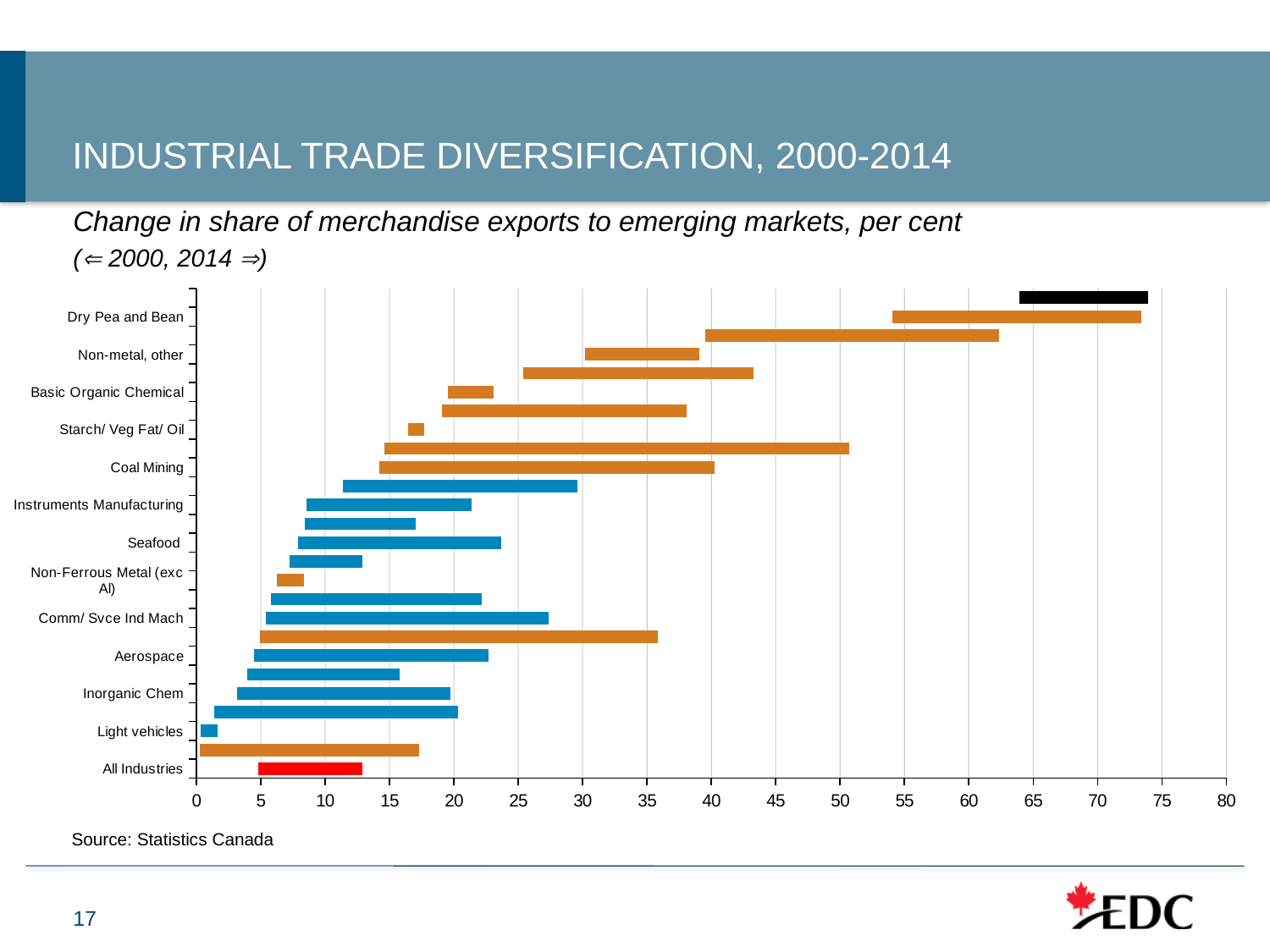
What colour is the bar for All Industries? red Is the 2014 value for All Industries greater or less than 10? greater What kind of chart is shown on the slide? bar chart Is the 2000 value for Non-metal, other greater or less than 25? greater Which has the higher 2000 share of exports to emerging markets, Basic Organic Chemical or Inorganic Chem? Basic Organic Chemical Among the labelled industries, which has the lowest 2014 share of exports to emerging markets? Light vehicles Among the labelled industries, which has the highest 2014 share of exports to emerging markets? Dry Pea and Bean Is the 2014 value for Light vehicles greater or less than 5? less Which has the higher 2014 share of exports to emerging markets, Coal Mining or Aerospace? Coal Mining What is the source cited for the chart? Statistics Canada